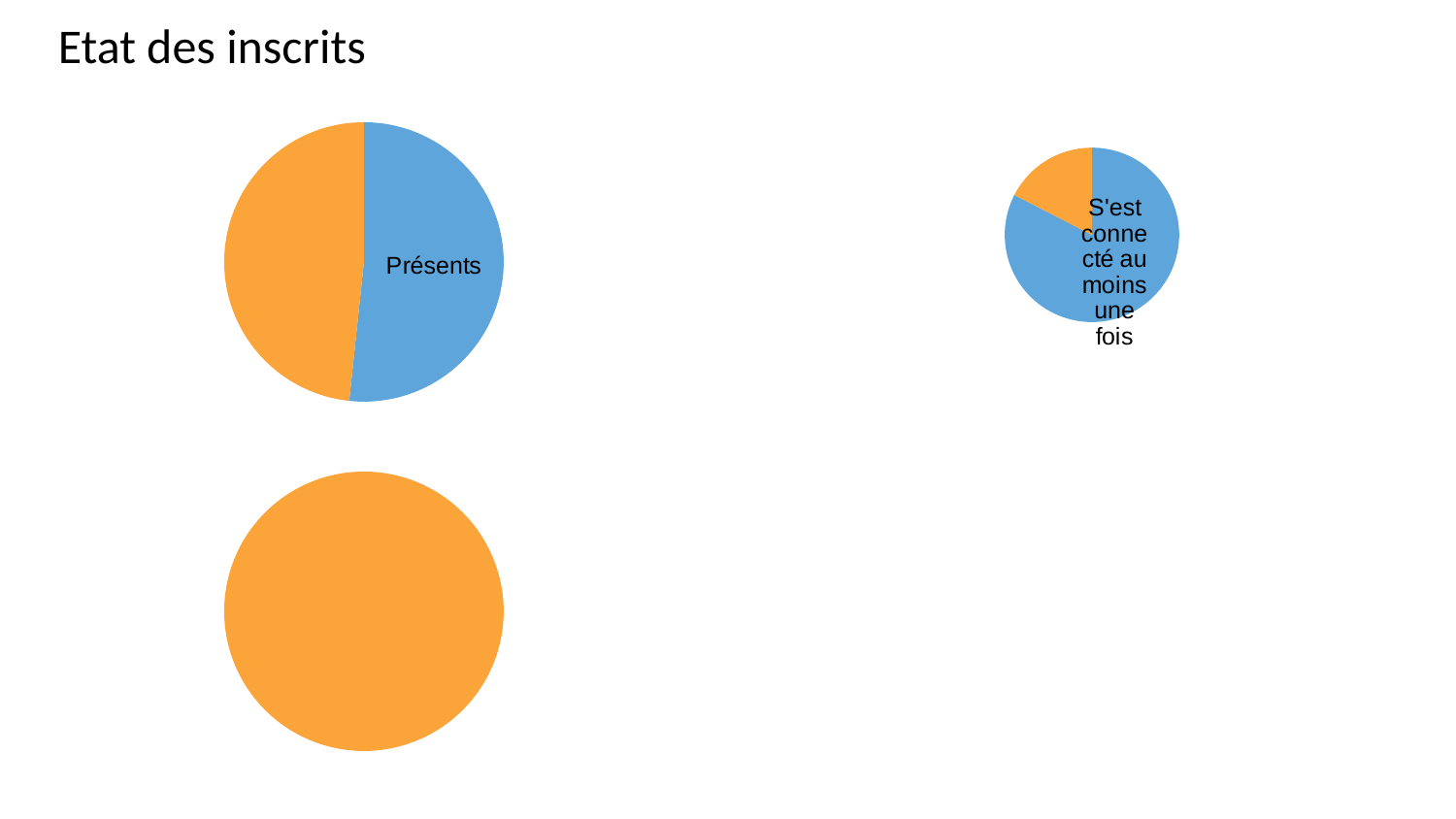
In the top-right pie chart, is the orange slice greater or less than half of the pie? less What label is shown on the blue slice of the top-right pie chart? S'est connecté au moins une fois What is the title of the slide? Etat des inscrits What kind of chart is the top-right chart on the slide? pie chart What kind of chart is the bottom-left chart on the slide? pie chart What label is shown on the blue slice of the top-left pie chart? Présents In the top-right pie chart, which slice is larger, the blue one or the orange one? the blue one What kind of chart is the top-left chart on the slide? pie chart How many slices does the top-left pie chart have? 2 In the top-right pie chart, is the blue slice greater or less than half of the pie? greater How many slices does the top-right pie chart have? 2